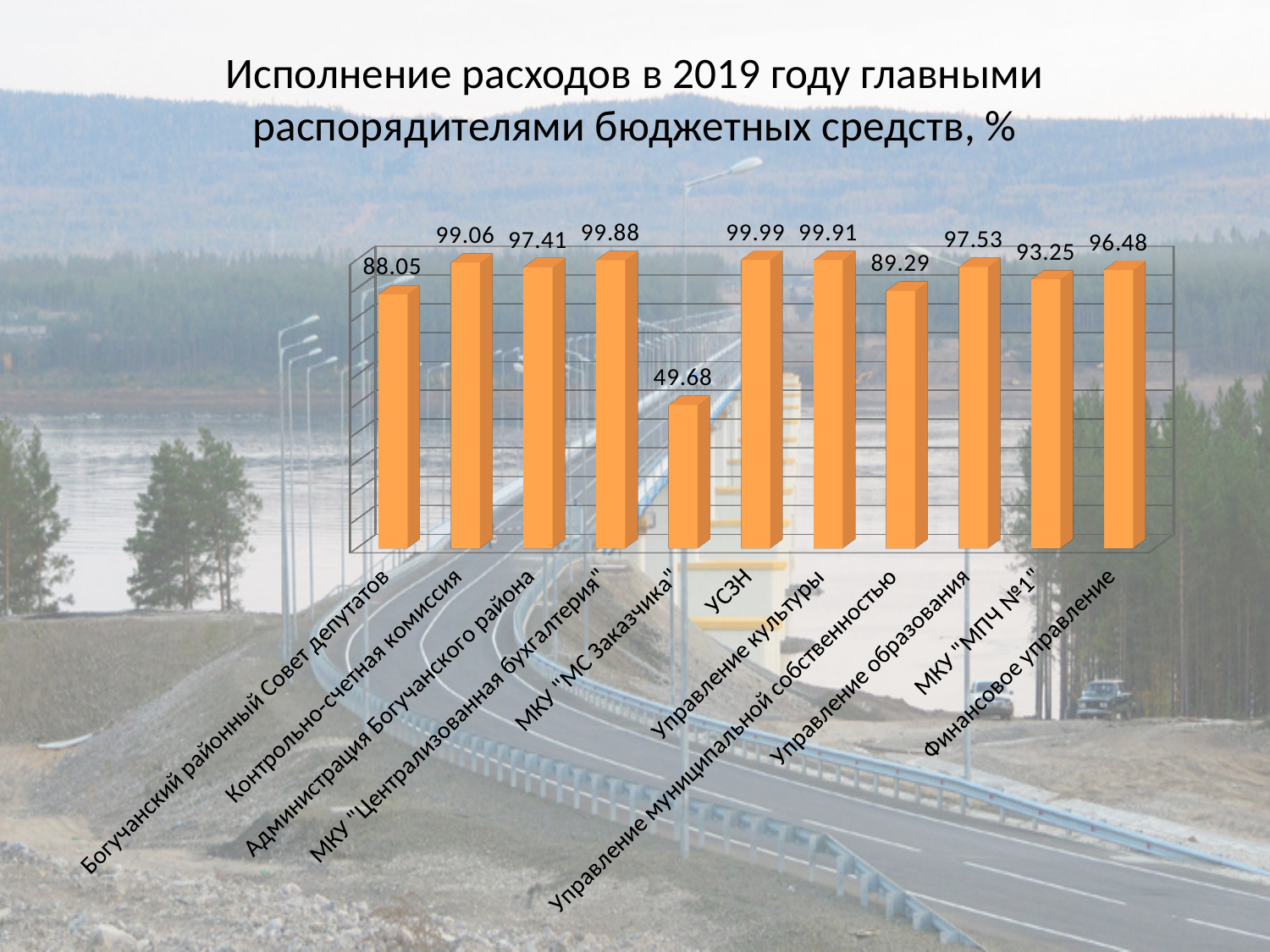
Which category has the lowest value? МКУ "МС Заказчика" What is the difference between the values for Контрольно-счетная комиссия and Богучанский районный Совет депутатов? 11.01 What is the value for МКУ "МС Заказчика"? 49.68 What is the value for Финансовое управление? 96.48 What kind of chart is shown on the slide? Bar chart What is the difference between the values for МКУ "Централизованная бухгалтерия" and МКУ "МС Заказчика"? 50.2 What is the value for Управление муниципальной собственностью? 89.29 What is the value for УСЗН? 99.99 Which is larger, the value for Управление образования or the value for МКУ "МПЧ №1"? Управление образования How many categories are shown in the chart? 11 What is the title of the chart? Исполнение расходов в 2019 году главными распорядителями бюджетных средств, % Which category has the highest value? УСЗН